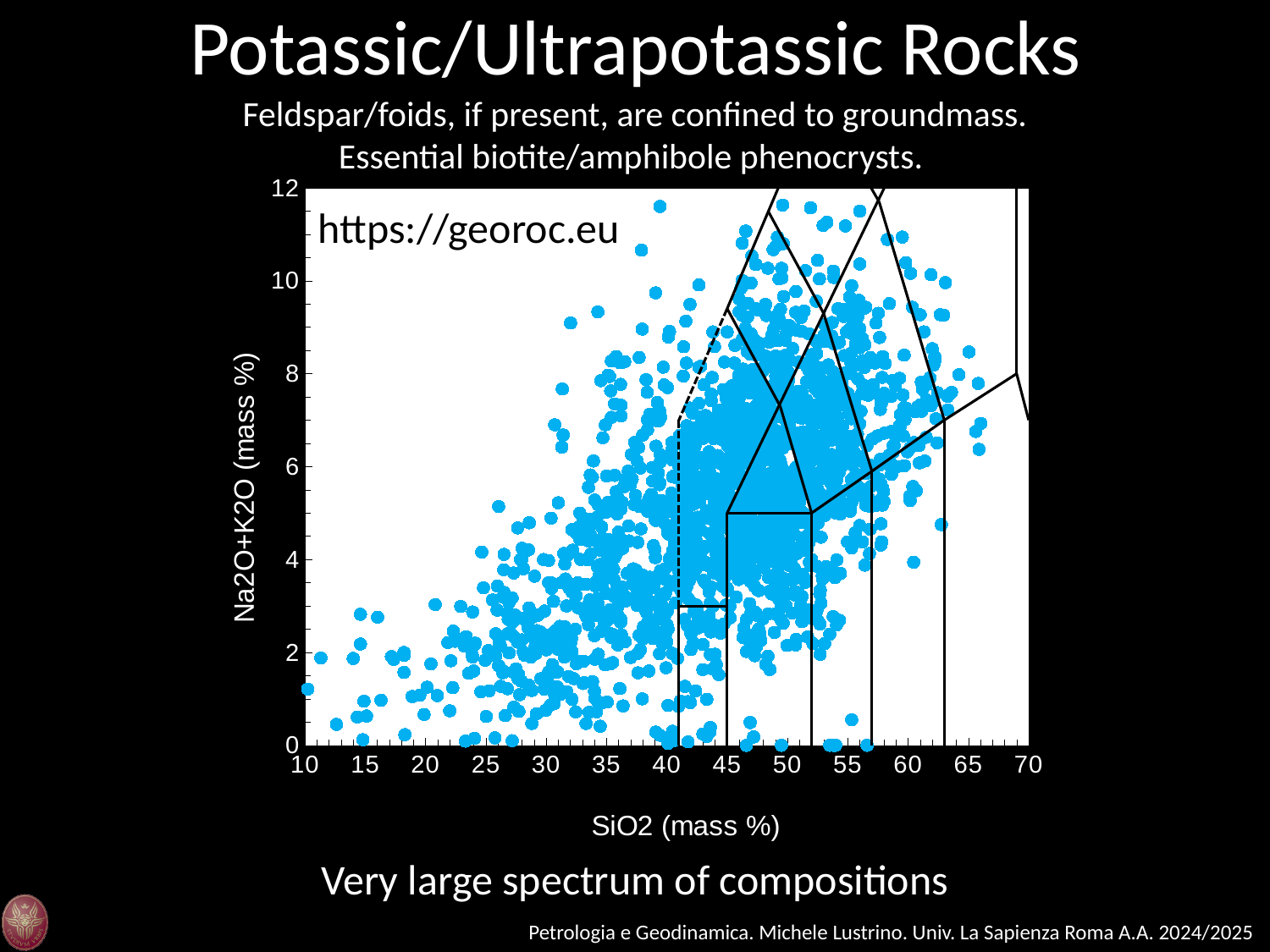
What is the label of the x axis of the chart? SiO2 (mass %) What is the maximum value shown on the x axis of the chart? 70 Is the highest SiO2 value plotted greater or less than 60? greater Overall, do the Na2O+K2O values of the points rise or fall as SiO2 increases along the x axis? rise What kind of chart is shown on the slide? scatter plot What is the maximum value shown on the y axis of the chart? 12 Is the highest Na2O+K2O value plotted greater or less than 12? less Is the highest Na2O+K2O value plotted greater or less than 10? greater What is the label of the y axis of the chart? Na2O+K2O (mass %)